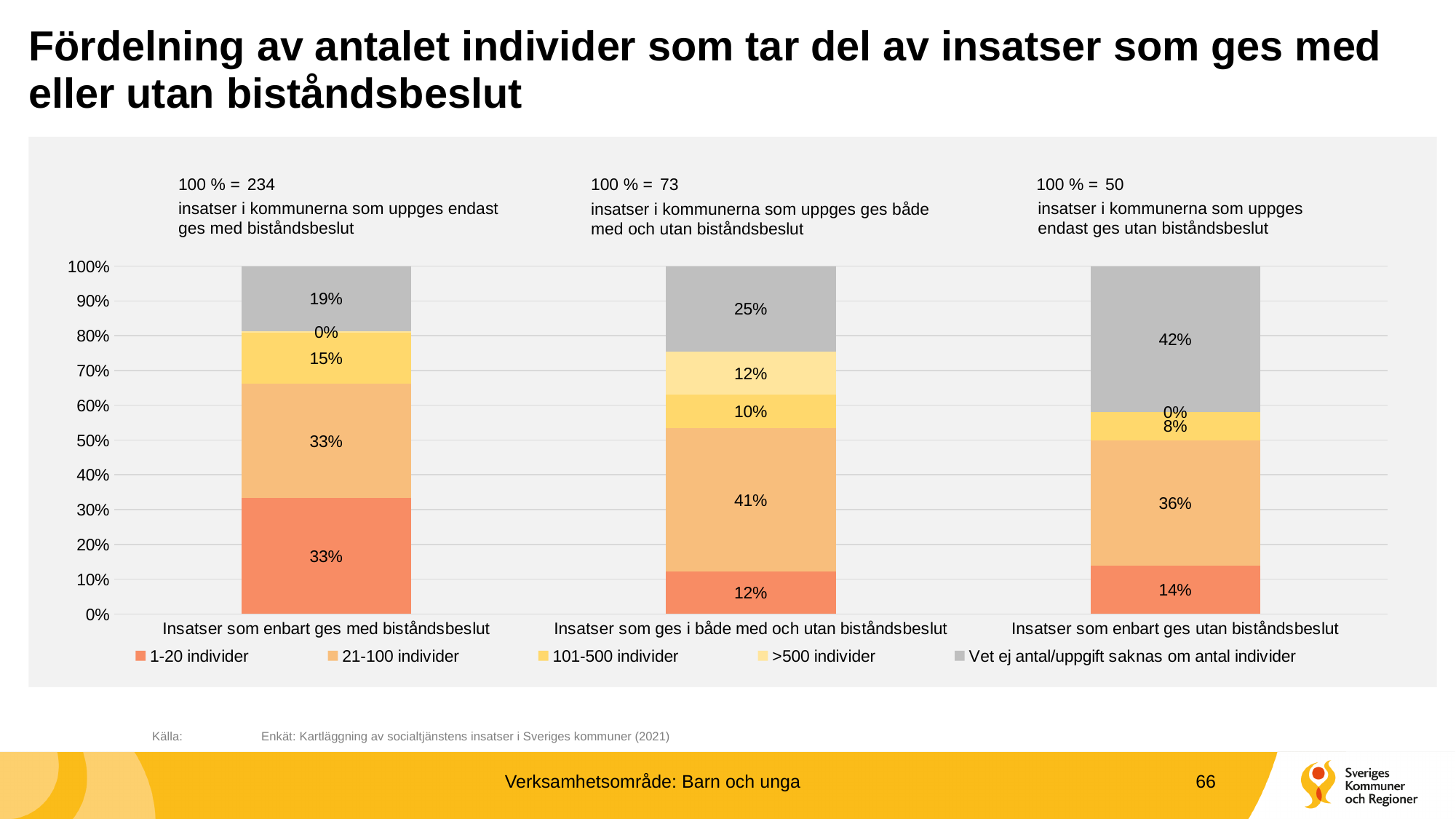
Which category has the highest value for 'Vet ej antal/uppgift saknas om antal individer'? Insatser som enbart ges utan biståndsbeslut What is the value for 'Vet ej antal/uppgift saknas om antal individer' in the category 'Insatser som enbart ges utan biståndsbeslut'? 42% Which category has the lowest value for '1-20 individer'? Insatser som ges i både med och utan biståndsbeslut How many series does the legend list? 5 What kind of chart is shown on the slide? Stacked bar chart What is the value for '>500 individer' in the category 'Insatser som ges i både med och utan biståndsbeslut'? 12% How many categories are shown on the x axis? 3 Which is larger: the '101-500 individer' value for 'Insatser som enbart ges med biståndsbeslut' or for 'Insatser som enbart ges utan biståndsbeslut'? Insatser som enbart ges med biståndsbeslut What is the value for '1-20 individer' in the category 'Insatser som enbart ges med biståndsbeslut'? 33% According to the text above the chart, how many insatser does 100% correspond to for the category 'Insatser som enbart ges med biståndsbeslut'? 234 What is the difference between the '21-100 individer' values for 'Insatser som ges i både med och utan biståndsbeslut' and 'Insatser som enbart ges med biståndsbeslut'? 8% What is the value for '21-100 individer' in the category 'Insatser som ges i både med och utan biståndsbeslut'? 41%